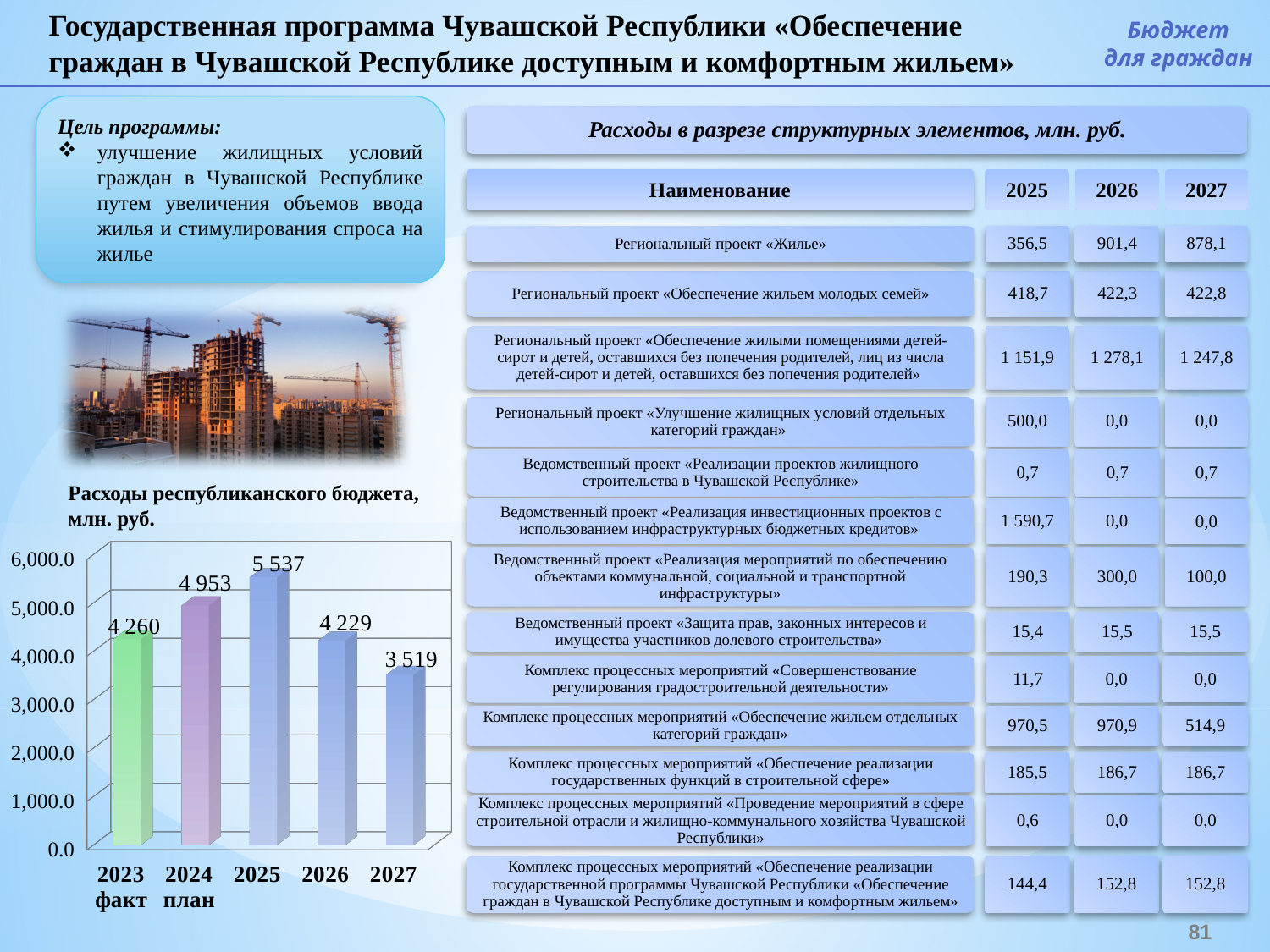
What is the value for 2025 in the chart 'Расходы республиканского бюджета, млн. руб.'? 5 537 How many bars are shown in the chart 'Расходы республиканского бюджета, млн. руб.'? 5 In the chart 'Расходы республиканского бюджета, млн. руб.', is the value for 2027 greater or less than 4,000.0? less What is the value for 2027 in the chart 'Расходы республиканского бюджета, млн. руб.'? 3 519 Which year has the highest value in the chart 'Расходы республиканского бюджета, млн. руб.'? 2025 In the chart 'Расходы республиканского бюджета, млн. руб.', what is the difference between the values for 2026 and 2027? 710 What kind of chart is 'Расходы республиканского бюджета, млн. руб.'? bar chart What is the value for 2023 (факт) in the chart 'Расходы республиканского бюджета, млн. руб.'? 4 260 In the chart 'Расходы республиканского бюджета, млн. руб.', do the values rise or fall from 2025 to 2027? fall In the chart 'Расходы республиканского бюджета, млн. руб.', what is the difference between the values for 2025 and 2023? 1 277 In the chart 'Расходы республиканского бюджета, млн. руб.', which is larger: the value for 2024 or the value for 2026? 2024 Which year has the lowest value in the chart 'Расходы республиканского бюджета, млн. руб.'? 2027